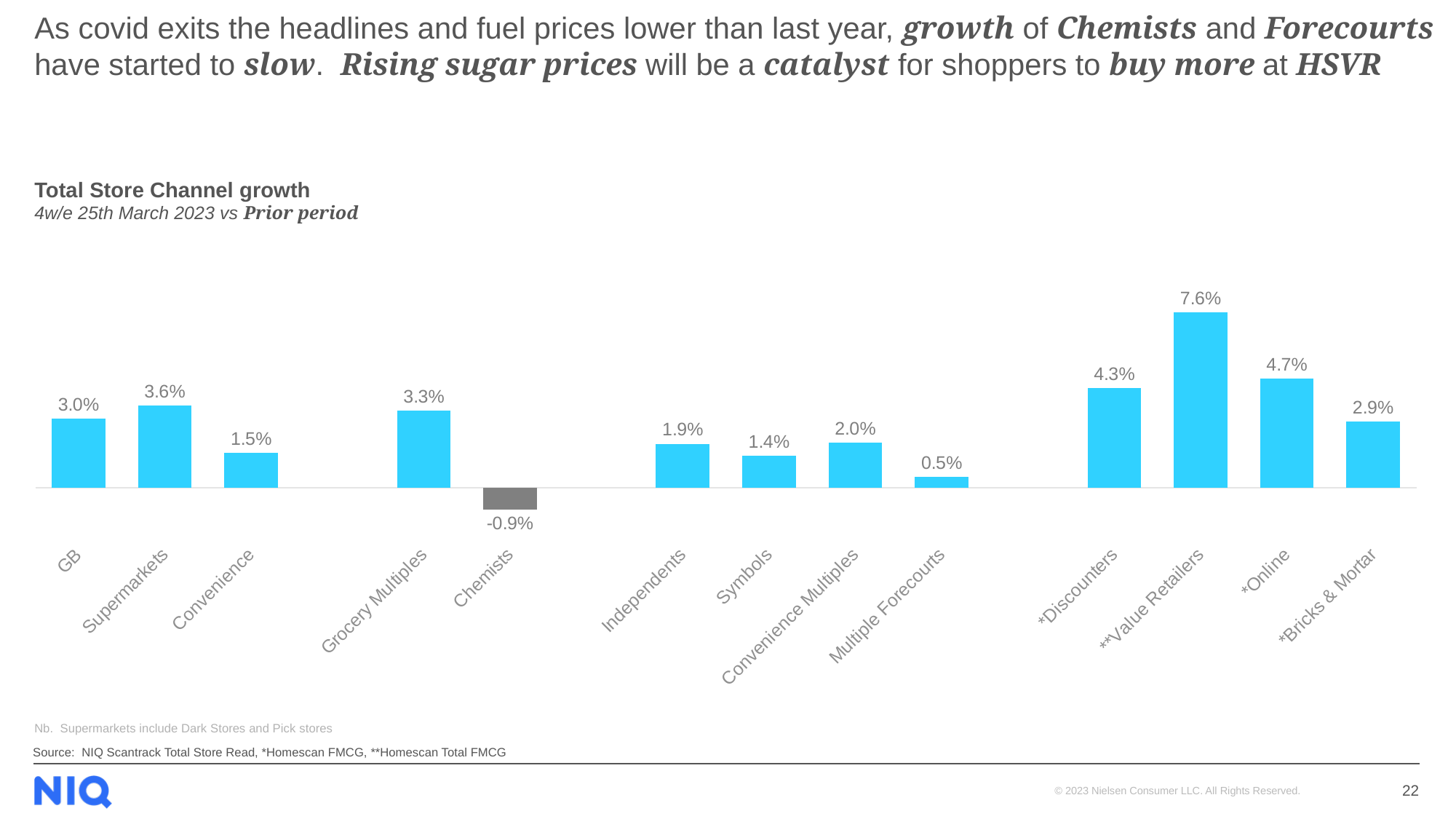
What is the growth value for Chemists? -0.9% Which is larger, the growth for Independents or Symbols? Independents What is the growth value for Supermarkets? 3.6% Which category has the highest growth? **Value Retailers What is the difference between the growth for GB and Convenience? 1.5% How many categories are shown in the chart? 14 What is the growth value for *Online? 4.7% What is the difference between the growth for **Value Retailers and *Discounters? 3.3% What is the title of the chart? Total Store Channel growth Which category has the lowest growth? Chemists What kind of chart is shown on the slide? Bar chart What is the growth value for Multiple Forecourts? 0.5%